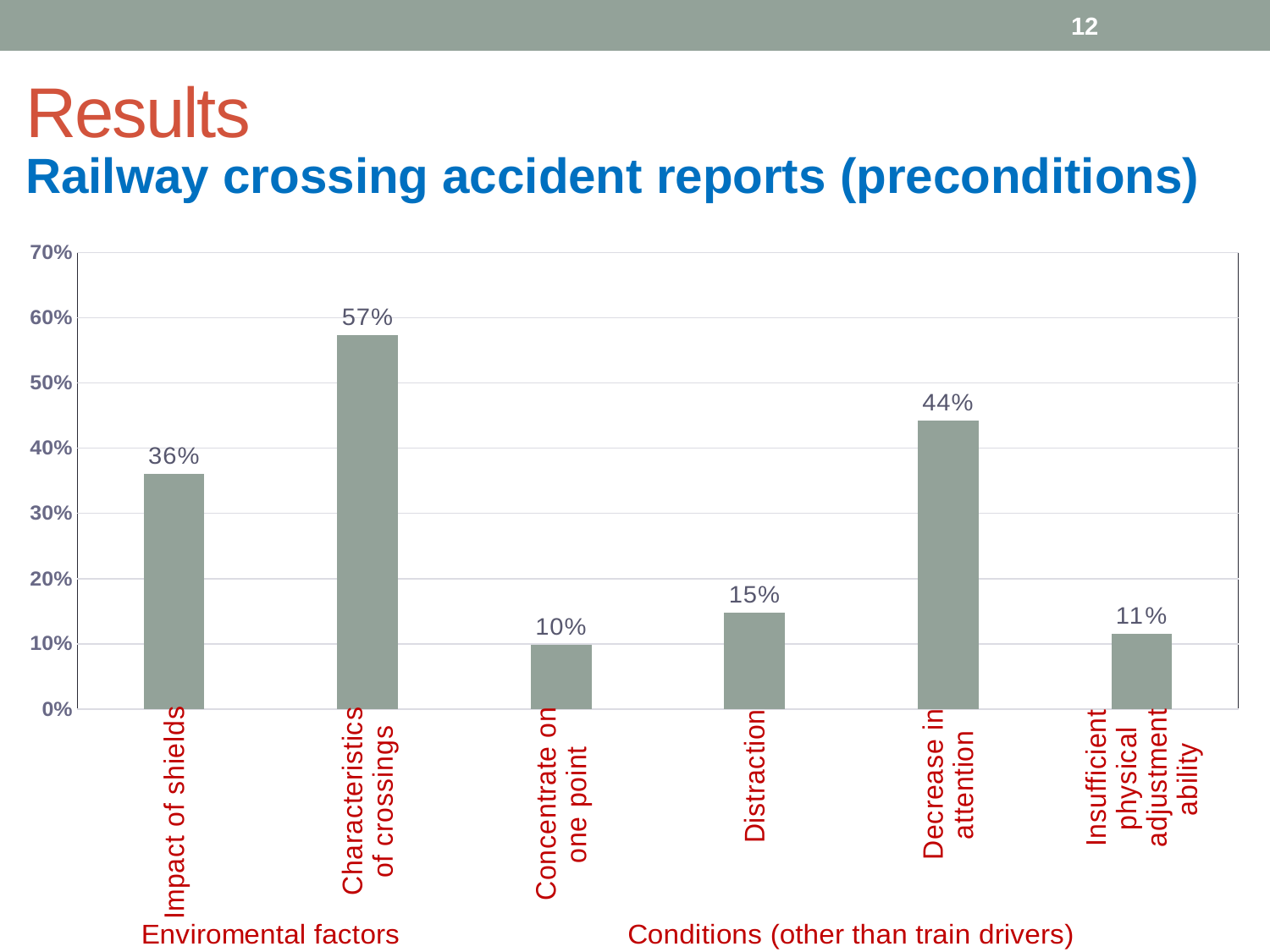
Which is larger, the value for Distraction or the value for Concentrate on one point? Distraction What is the value for Impact of shields? 36% What is the value for Characteristics of crossings? 57% How many categories are shown in the chart? 6 Which category has the highest value? Characteristics of crossings Is the value for Impact of shields greater or less than 30%? greater Which group label covers the first two bars of the chart? Enviromental factors What kind of chart is shown on the slide? Bar chart What is the value for Decrease in attention? 44% Which category has the lowest value? Concentrate on one point What is the value for Insufficient physical adjustment ability? 11% What is the difference between the values for Characteristics of crossings and Decrease in attention? 13%